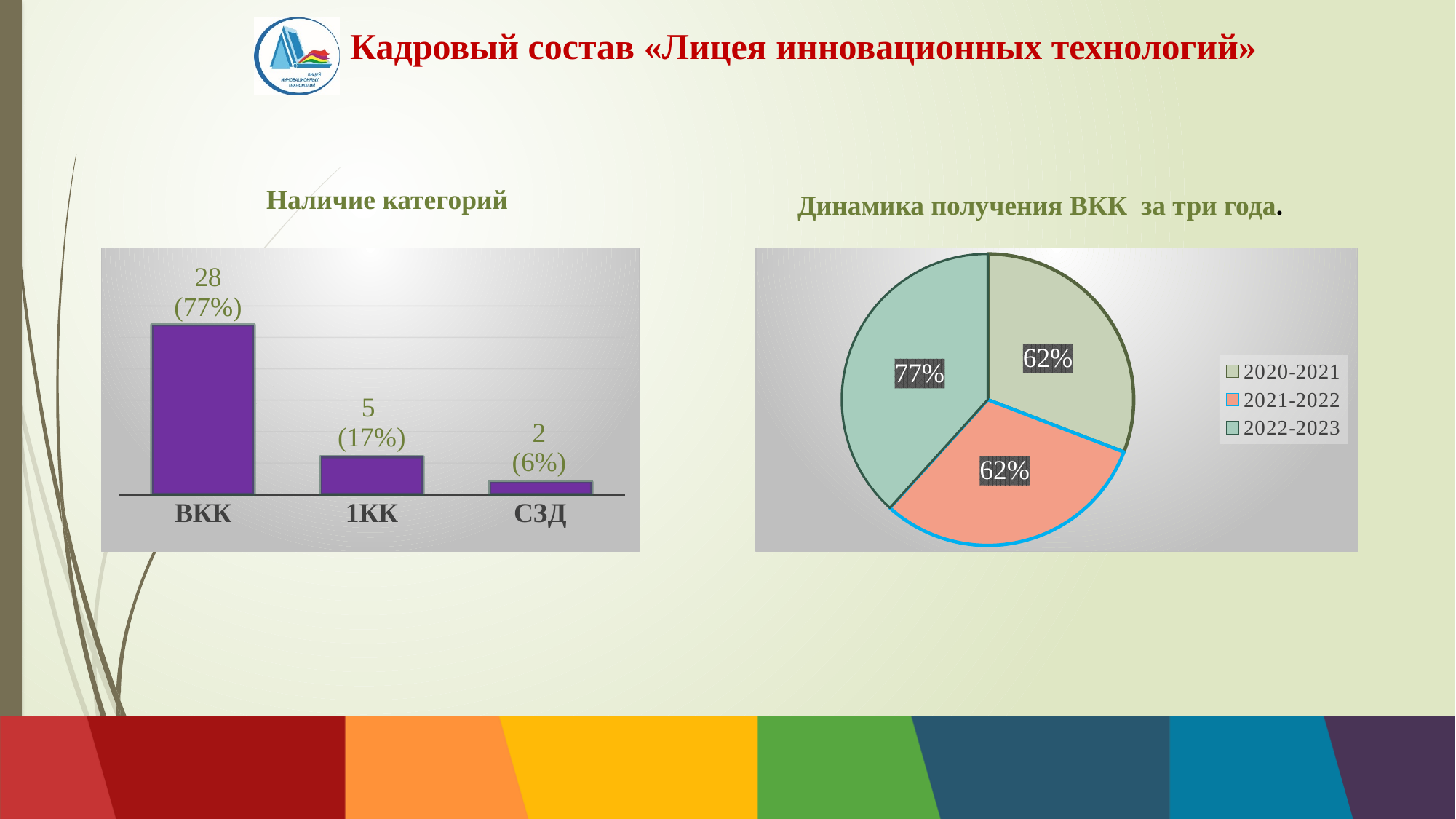
In the chart titled «Наличие категорий», what is the value for 1КК? 5 (17%) In the chart titled «Динамика получения ВКК за три года», what percentage is shown for 2022-2023? 77% What kind of chart is the one titled «Наличие категорий»? Bar chart In the chart titled «Наличие категорий», what is the value for ВКК? 28 (77%) How many entries does the legend of the chart titled «Динамика получения ВКК за три года» list? 3 In the chart titled «Наличие категорий», what percentage is shown for СЗД? 6% In the chart titled «Динамика получения ВКК за три года», what percentage is shown for 2020-2021? 62% In the chart titled «Наличие категорий», which category has the highest value? ВКК In the chart titled «Наличие категорий», which category has the lowest value? СЗД In the chart titled «Наличие категорий», how many categories are shown? 3 In the chart titled «Наличие категорий», what is the difference between the counts for ВКК and 1КК? 23 What kind of chart is the one titled «Динамика получения ВКК за три года»? Pie chart